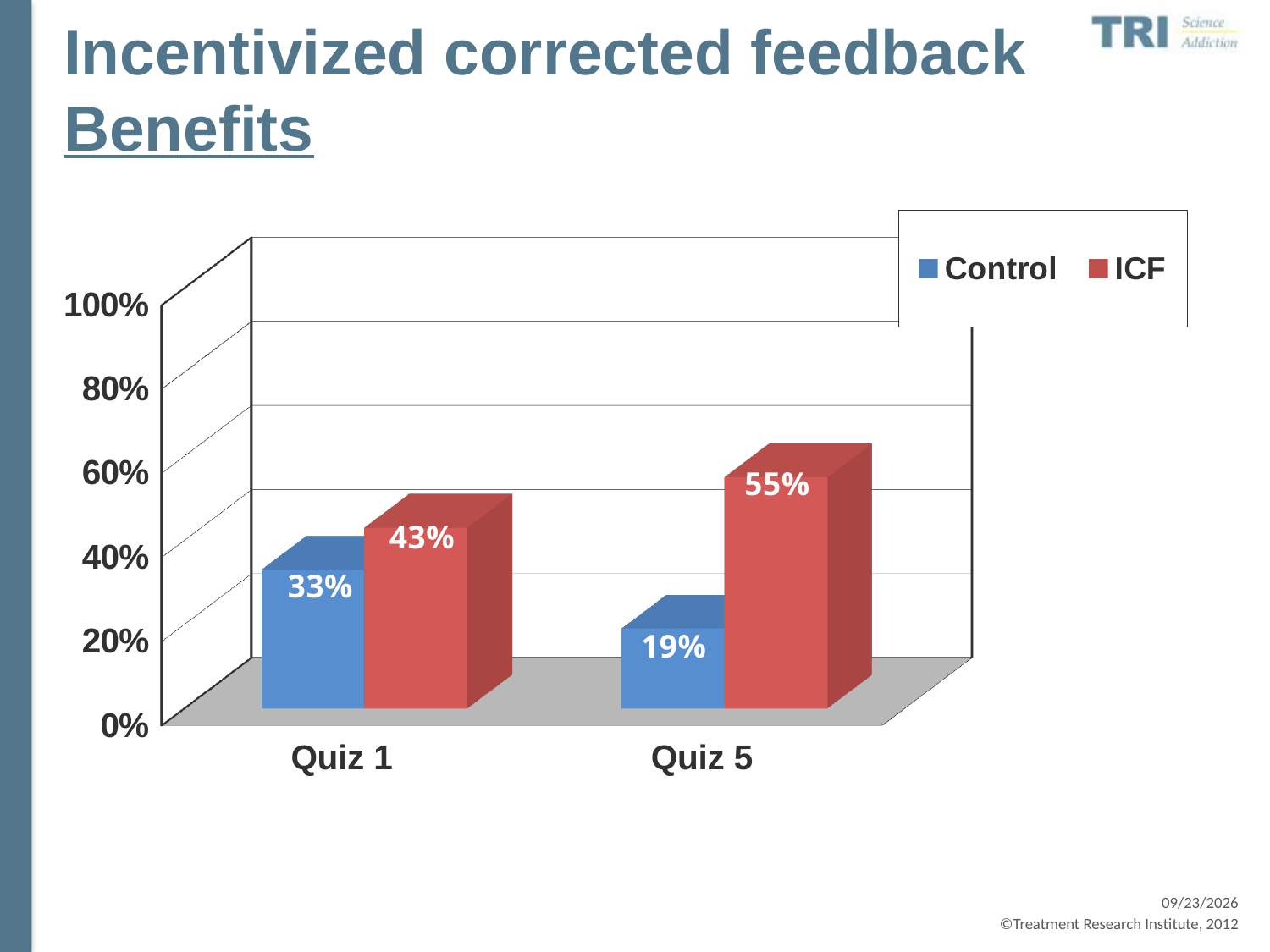
What is the value for ICF at Quiz 1? 43% Which bar shows the lowest value on the chart? Control at Quiz 5 How many series does the legend list? 2 What is the difference between ICF and Control at Quiz 1? 10% Does the Control series rise or fall from Quiz 1 to Quiz 5? Fall What is the difference between ICF and Control at Quiz 5? 36% Which series has the highest value at Quiz 5? ICF What is the value for ICF at Quiz 5? 55% What is the value for Control at Quiz 1? 33% What kind of chart is shown on the slide? Bar chart What is the value for Control at Quiz 5? 19% Which is larger, Control at Quiz 1 or ICF at Quiz 1? ICF at Quiz 1